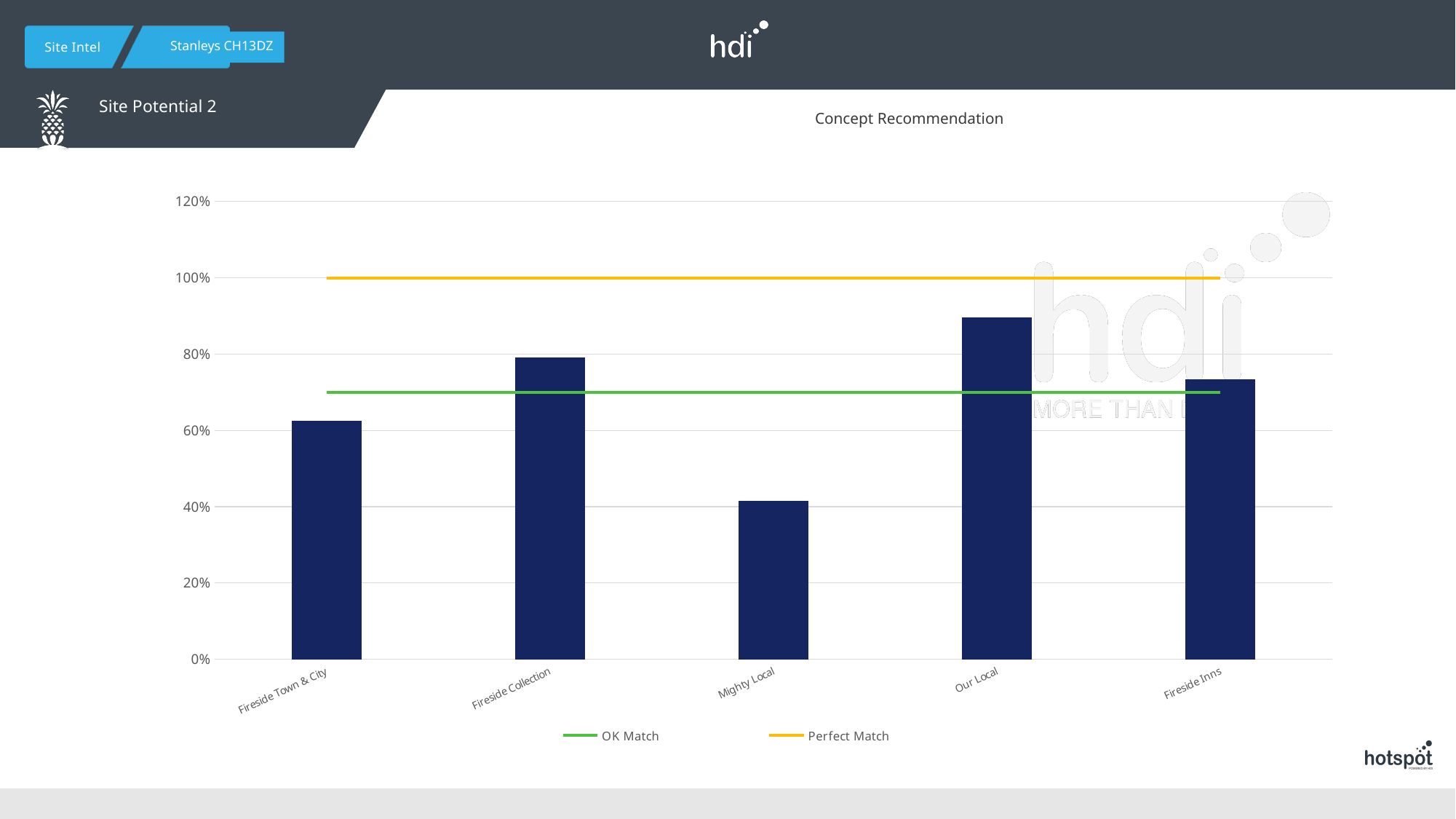
Is the value for Our Local greater or less than 80%? greater How many categories are shown on the x axis? 5 What kind of chart is shown on the slide? Combination bar and line chart (bars with two horizontal reference lines) Is the value for Fireside Inns greater or less than 60%? greater Is the value for Fireside Town & City greater or less than 80%? less How many entries does the legend list? 2 Which category has the tallest bar? Our Local Which category has the shortest bar? Mighty Local Which bar is taller, Fireside Collection or Fireside Inns? Fireside Collection What colour is the Perfect Match line in the legend? Yellow Which bar is taller, Our Local or Fireside Town & City? Our Local